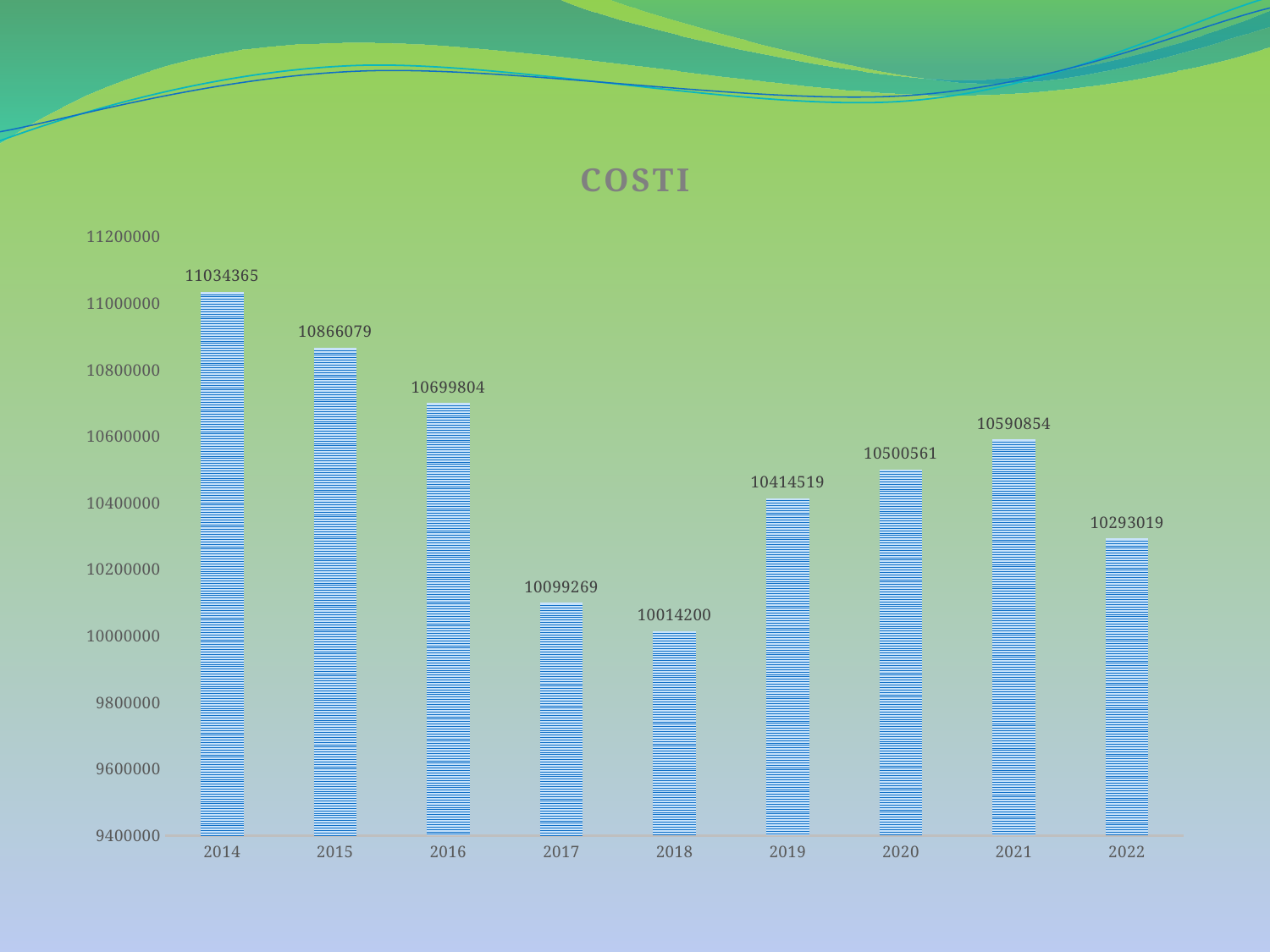
What is the difference between the values for 2021 and 2020? 90293 What is the value for 2018? 10014200 What is the value for 2014? 11034365 Which year has the highest value? 2014 What is the value for 2022? 10293019 How many years are shown on the x axis? 9 What kind of chart is this? bar chart Do the values rise or fall from 2014 to 2018? fall What is the difference between the values for 2014 and 2018? 1020165 Which year has the lowest value? 2018 Is the value for 2017 greater or less than 10200000? less Which is larger, the value for 2019 or the value for 2022? 2019